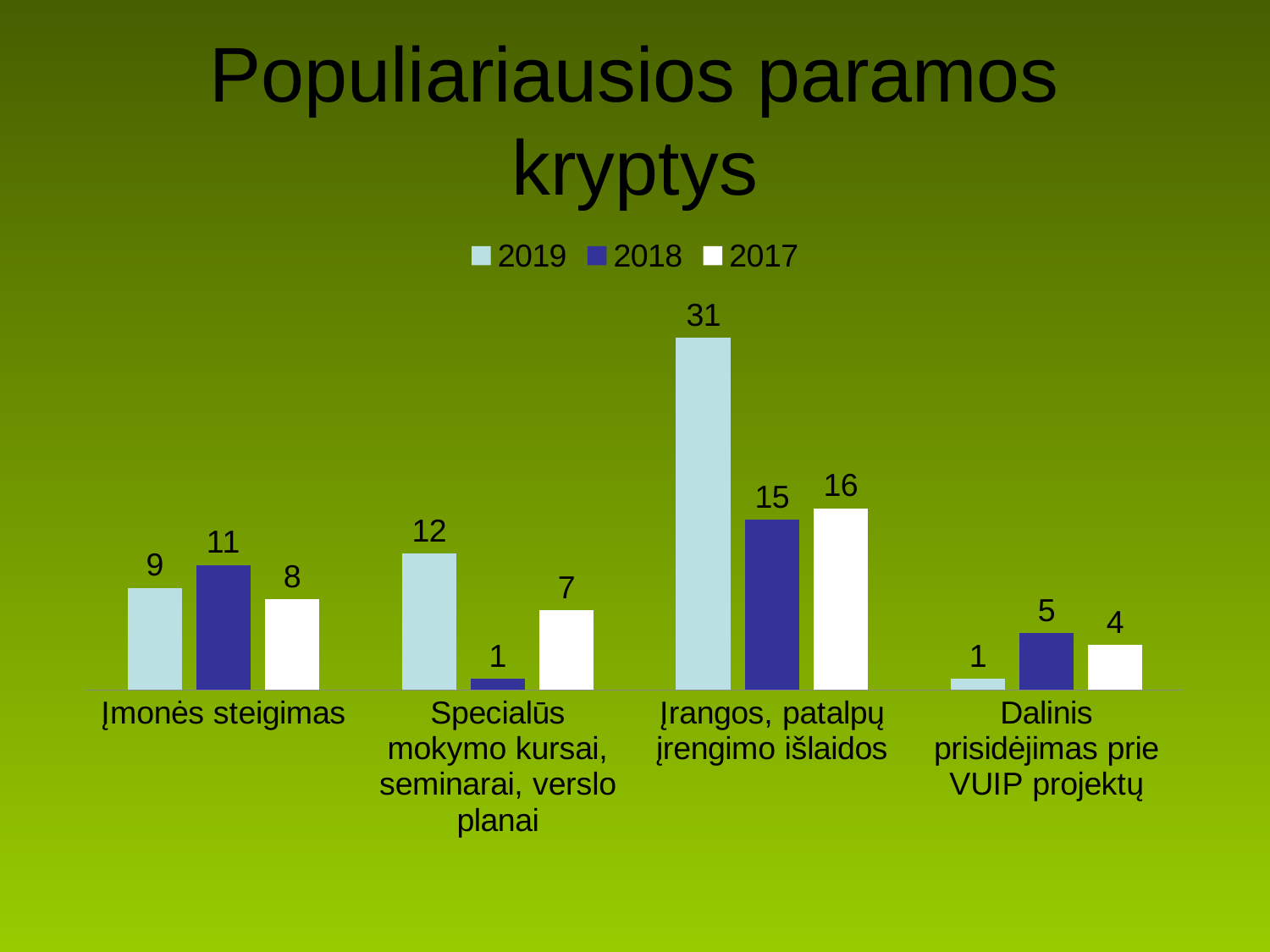
What is the difference between the 2019 and 2018 values in the "Įrangos, patalpų įrengimo išlaidos" category? 16 What is the value for 2018 in the "Įmonės steigimas" category? 11 What is the title of the slide? Populiariausios paramos kryptys Which is larger in the "Įmonės steigimas" category: the 2019 value or the 2017 value? 2019 How many categories are shown on the x axis? 4 What is the value for 2017 in the "Specialūs mokymo kursai, seminarai, verslo planai" category? 7 Which category has the lowest value for 2018? Specialūs mokymo kursai, seminarai, verslo planai What is the value for 2019 in the "Įrangos, patalpų įrengimo išlaidos" category? 31 Which category has the highest value for 2019? Įrangos, patalpų įrengimo išlaidos What is the value for 2019 in the "Dalinis prisidėjimas prie VUIP projektų" category? 1 What kind of chart is shown on the slide? Bar chart How many series does the legend list? 3